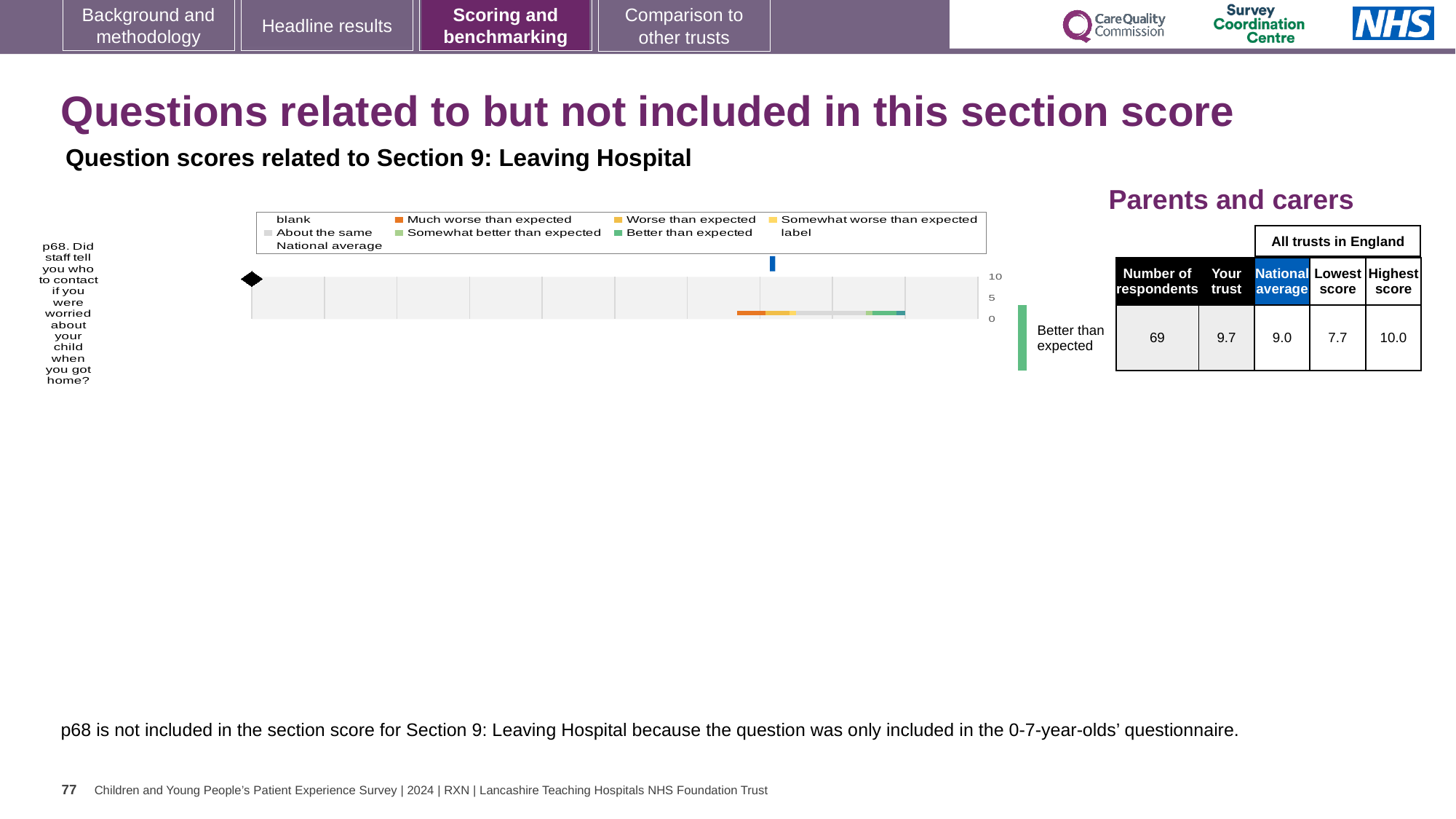
What colour represents 'Much worse than expected' in the chart legend? orange What is the 'Your trust' score for question p68? 9.7 What is the difference between the highest and lowest scores for question p68? 2.3 How many respondents answered question p68? 69 What is the difference between the 'Your trust' score and the national average for question p68? 0.7 What is the national average score for question p68? 9.0 What is the lowest score among all trusts in England for question p68? 7.7 What benchmarking category is question p68 rated as? Better than expected What is the highest score among all trusts in England for question p68? 10.0 How many survey questions are plotted on the chart? 1 What type of chart is used to show the p68 question score? bar chart Which is higher for question p68: the 'Your trust' score or the national average? Your trust